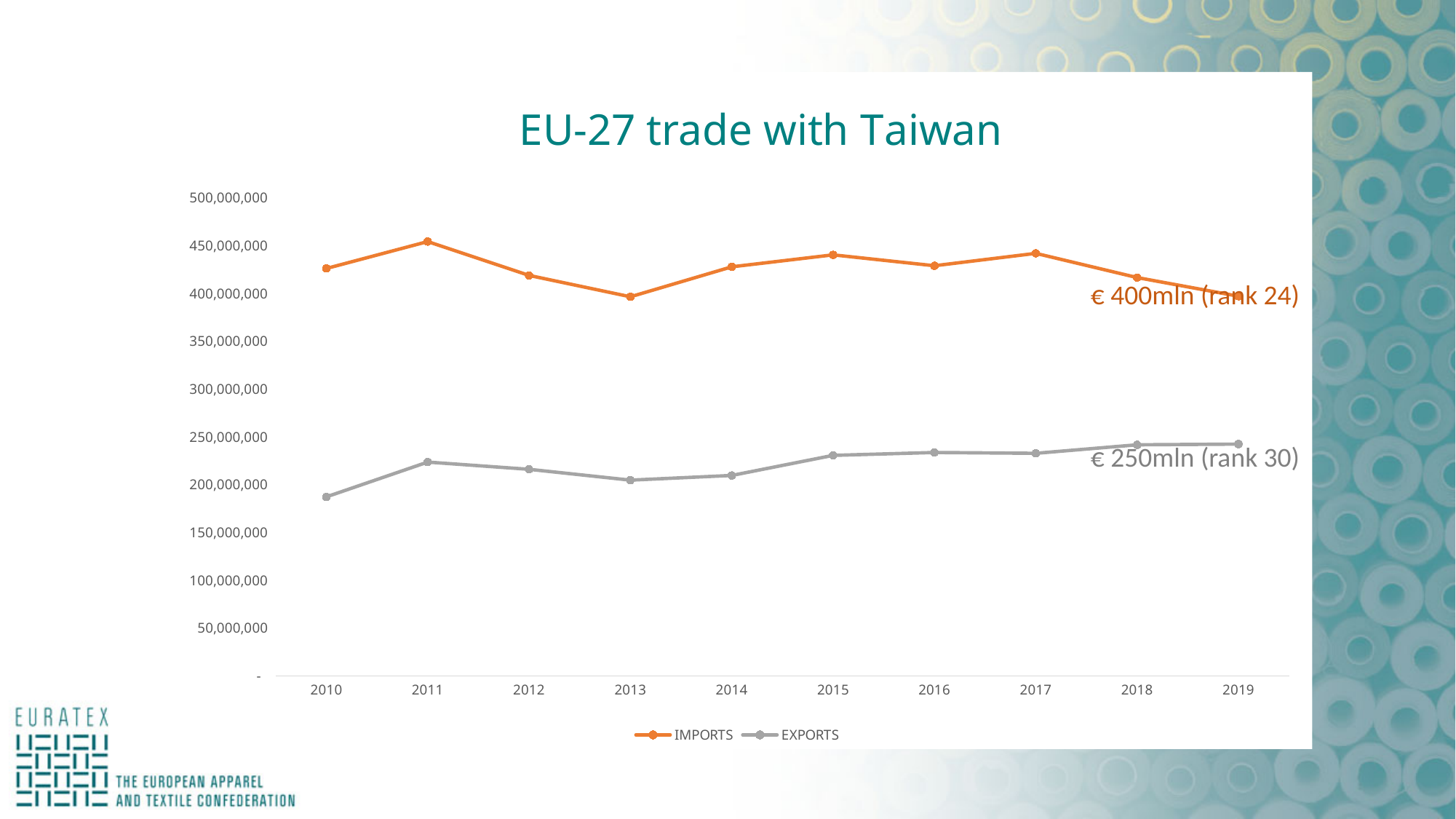
How many years are shown on the x axis? 10 Is the value for EXPORTS in 2016 greater or less than 200,000,000? greater What annotation is shown next to the IMPORTS line? € 400mln (rank 24) In which year were EXPORTS lowest? 2010 What kind of chart is shown on the slide? Line chart Is the value for IMPORTS in 2015 greater or less than 400,000,000? greater Which is larger in 2017, IMPORTS or EXPORTS? IMPORTS What is the title of the chart? EU-27 trade with Taiwan In which year were IMPORTS highest? 2011 Is the value for EXPORTS in 2010 greater or less than 200,000,000? less Do EXPORTS generally rise or fall from 2010 to 2019? rise How many series does the legend list? 2